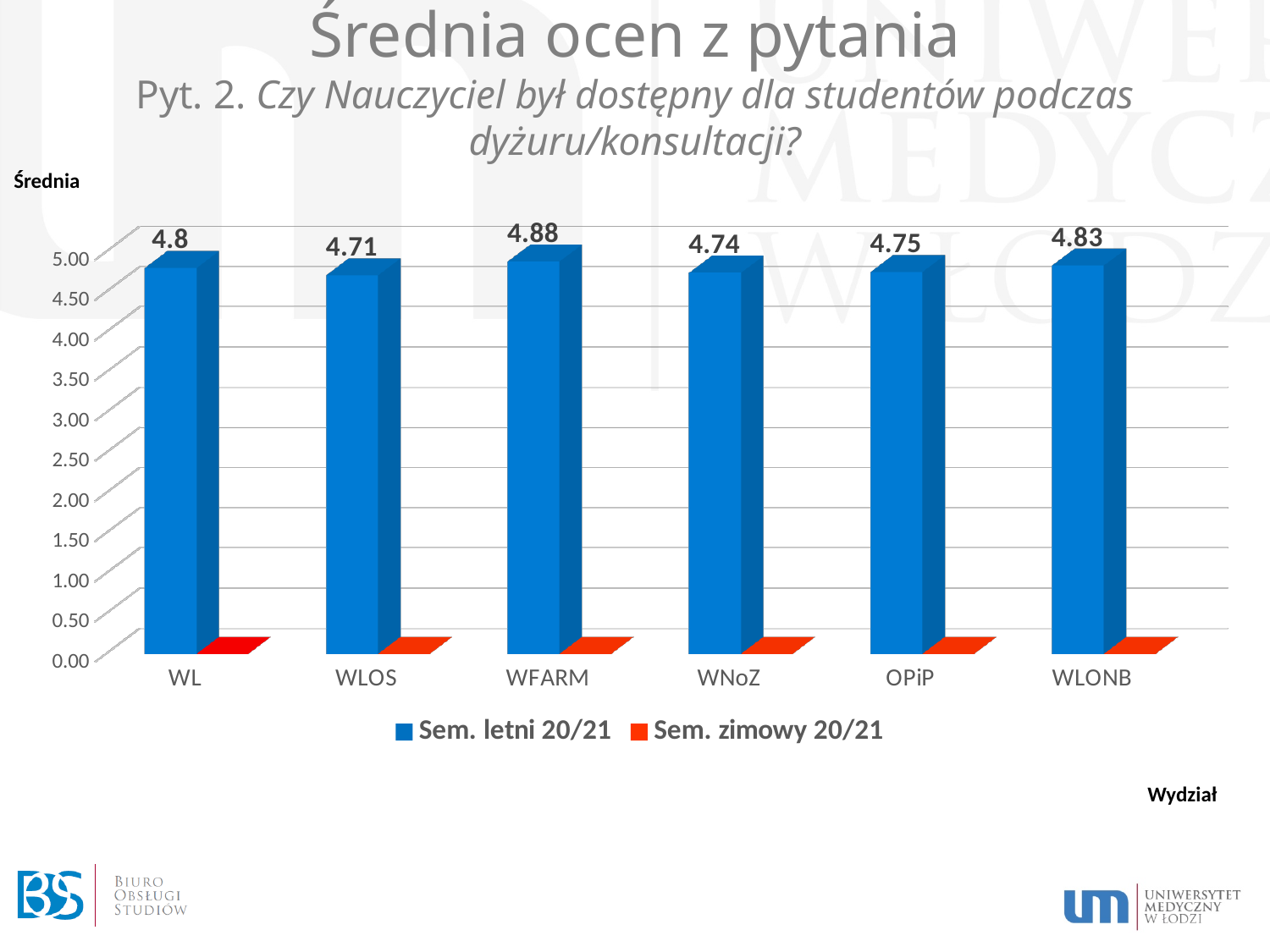
How many series does the legend list? 2 Which faculty has the highest Sem. letni 20/21 average? WFARM Which has a higher Sem. letni 20/21 value, WNoZ or WLONB? WLONB What is the Sem. letni 20/21 value for WLONB? 4.83 What is the Sem. letni 20/21 value for OPiP? 4.75 How many faculties are shown on the x axis? 6 What kind of chart is shown on the slide? Bar chart Which series is shown in red in the legend? Sem. zimowy 20/21 What is the difference between the Sem. letni 20/21 values for WFARM and WLOS? 0.17 What is the Sem. letni 20/21 value for WL? 4.8 Which faculty has the lowest Sem. letni 20/21 average? WLOS What is the Sem. letni 20/21 value for WFARM? 4.88